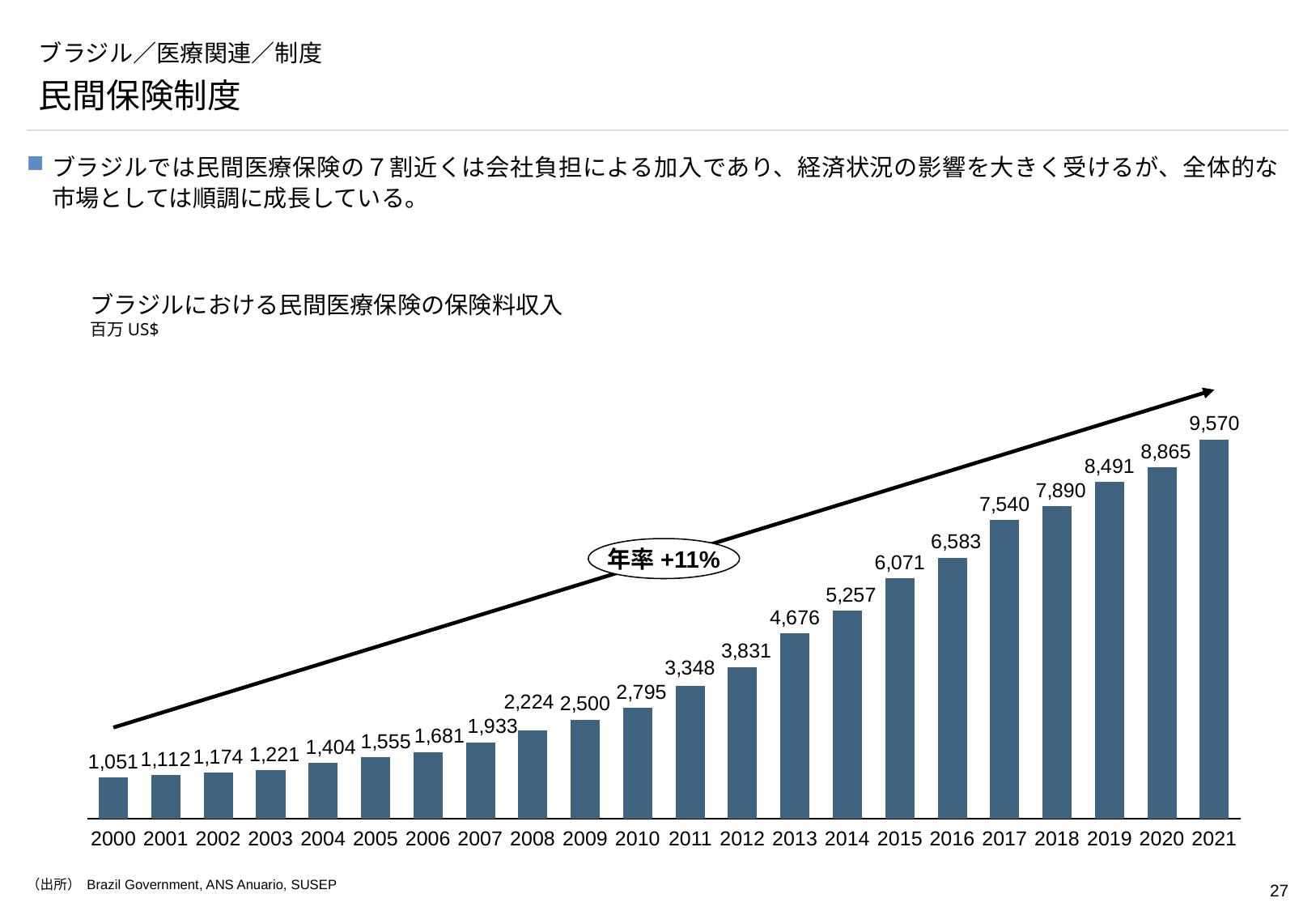
What is the difference between the values for 2015 and 2014? 814 Which year has the highest value? 2021 What kind of chart is this? bar chart Which is larger, the value for 2009 or the value for 2010? 2010 What annual growth rate is shown in the label on the arrow? 年率 +11% What is the difference between the values for 2021 and 2020? 705 How many years are shown on the x axis? 22 What is the value for 2012? 3,831 Which year has the lowest value? 2000 What is the value for 2000? 1,051 What is the value for 2021? 9,570 Do the values rise or fall from 2000 to 2021? rise